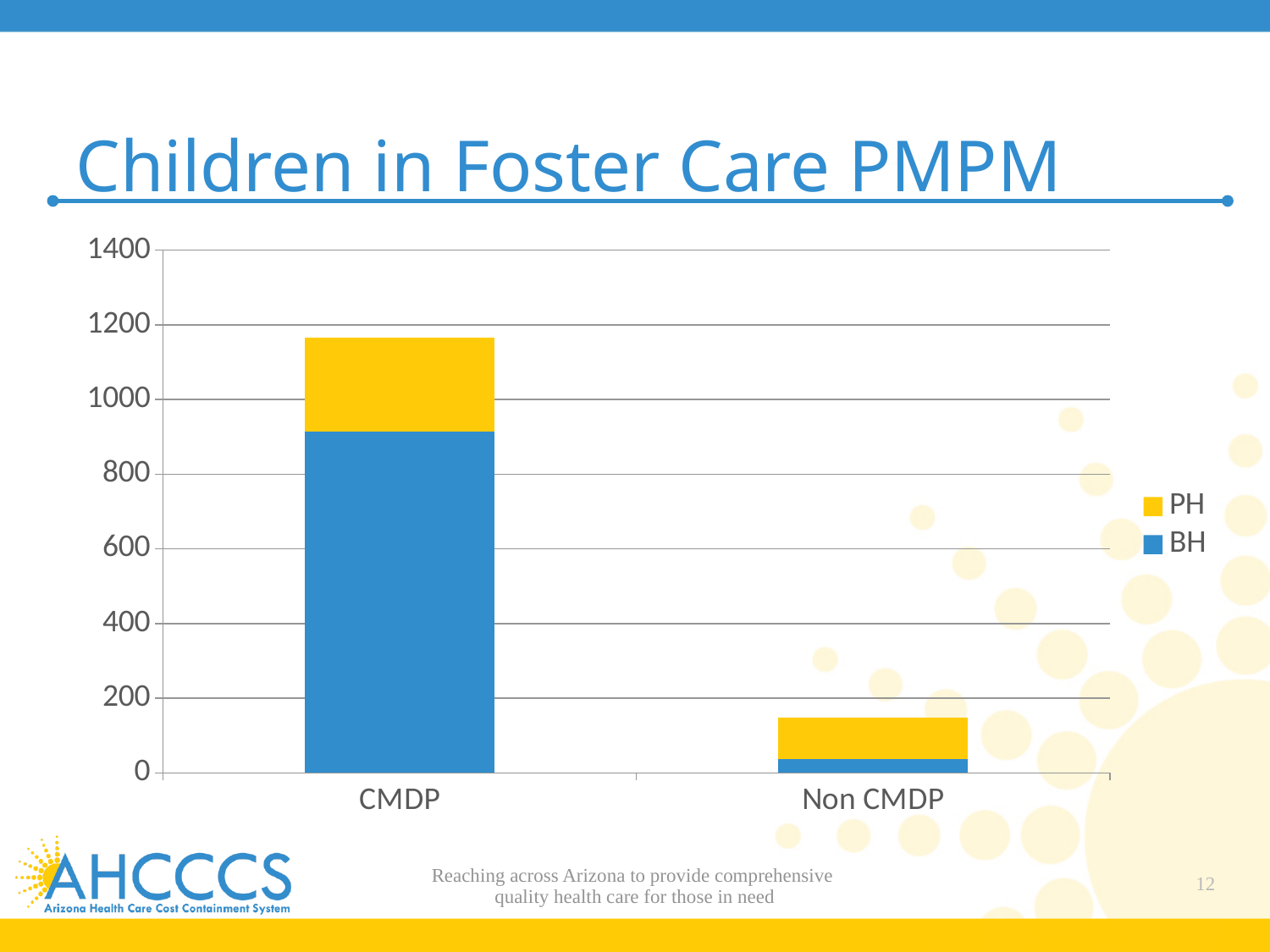
Which is larger for CMDP, the BH segment or the PH segment? BH Which series is shown in yellow? PH Which category has the lowest total bar? Non CMDP What is the title of the chart? Children in Foster Care PMPM Is the total bar for CMDP greater or less than 1000? greater How many categories are shown on the x axis? 2 Which is larger for Non CMDP, the BH segment or the PH segment? PH Which category has the highest total bar? CMDP Is the BH value for CMDP greater or less than 800? greater What kind of chart is shown on the slide? Stacked bar chart How many series does the legend list? 2 Is the total bar for Non CMDP greater or less than 200? less